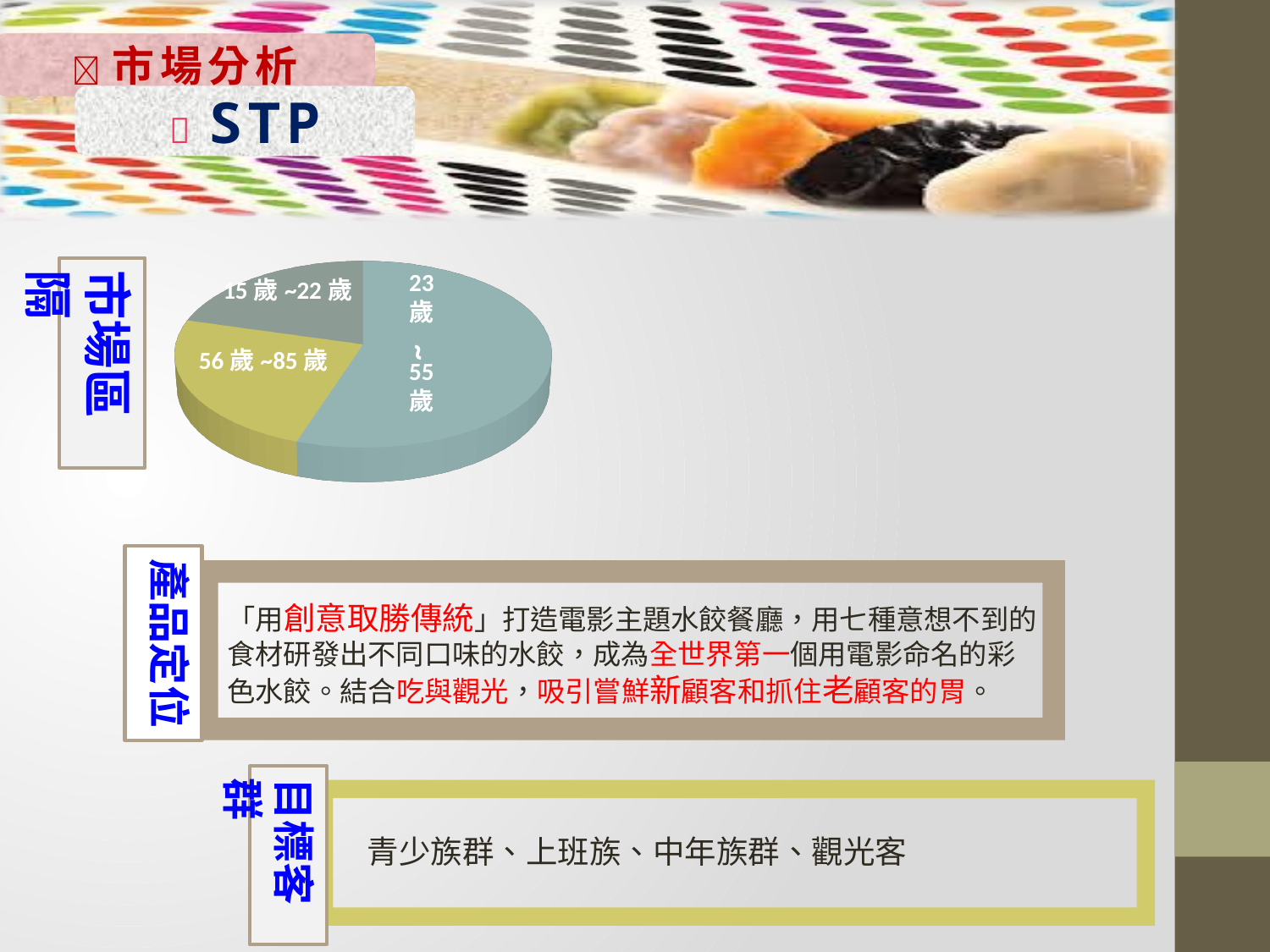
How many slices does the pie chart have? 3 What kind of chart is shown on the slide? pie chart Which age group is shown in the yellow slice of the pie chart? 56歲~85歲 Which age group is shown in the grey slice of the pie chart? 15歲~22歲 Which age group has the largest slice in the pie chart? 23歲~55歲 Which slice is larger in the pie chart, 15歲~22歲 or 23歲~55歲? 23歲~55歲 Which slice is larger in the pie chart, 23歲~55歲 or 56歲~85歲? 23歲~55歲